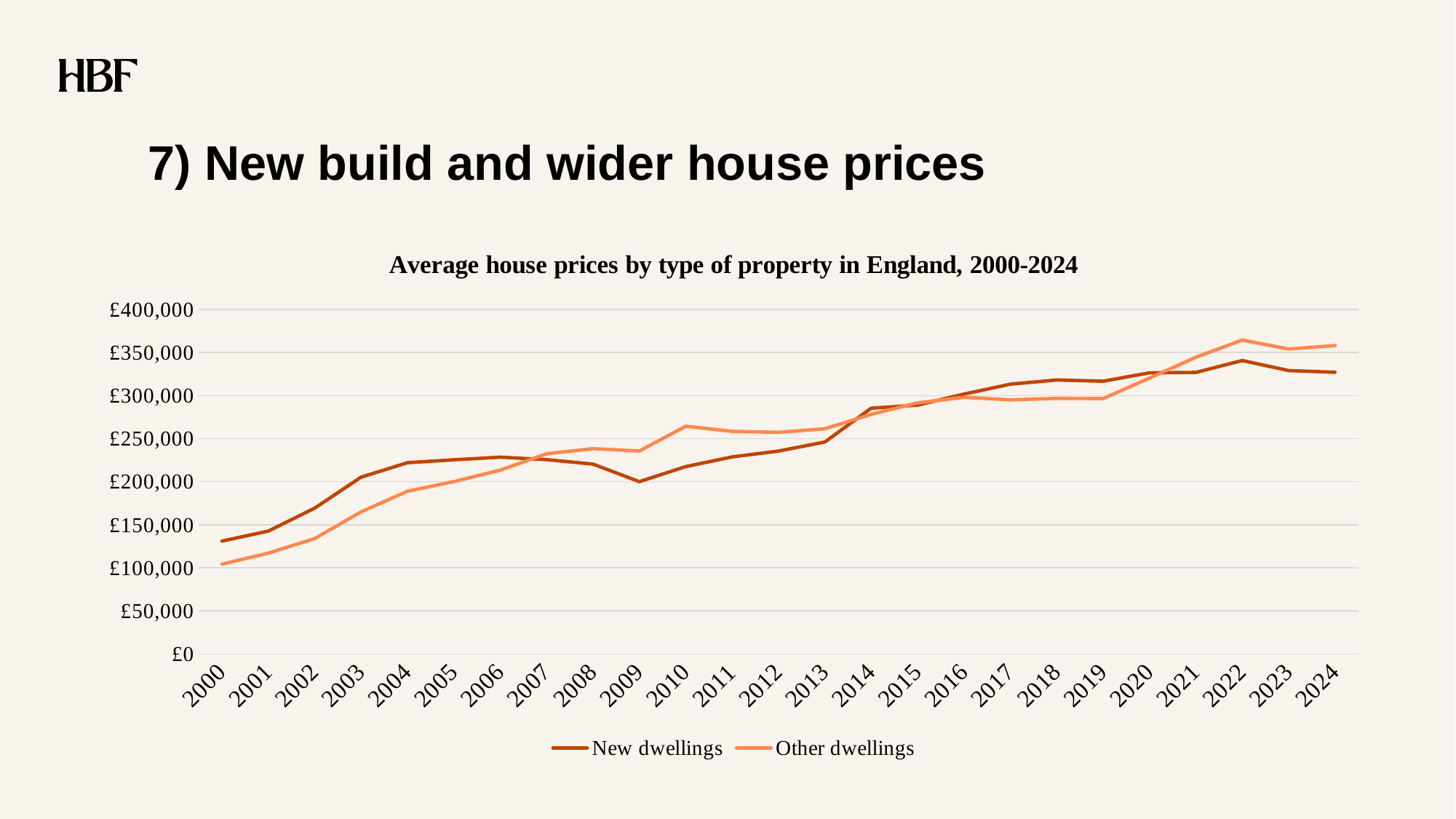
In 2000, which series has the higher value, New dwellings or Other dwellings? New dwellings In which year is the New dwellings series at its lowest value? 2000 What kind of chart is shown on the slide? Line chart In 2024, which series has the higher value, New dwellings or Other dwellings? Other dwellings Is the value for Other dwellings in 2022 greater or less than £350,000? greater Is the value for New dwellings in 2000 greater or less than £150,000? less Is the value for Other dwellings in 2000 greater or less than £150,000? less In which year does the Other dwellings series reach its highest value? 2022 Overall, do the house prices rise or fall from 2000 to 2024? Rise How many years are plotted along the x axis? 25 How many series does the legend list? 2